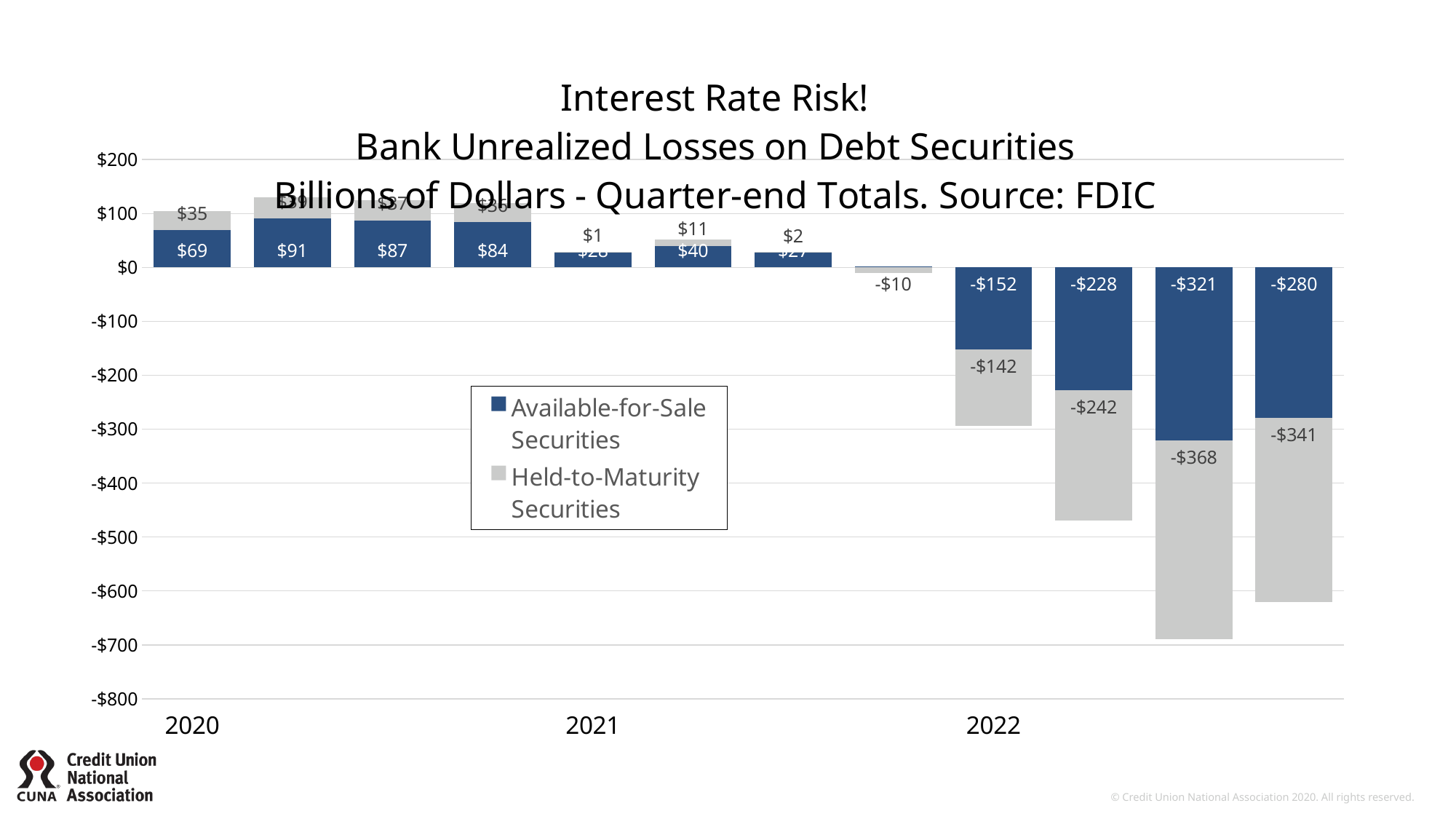
In the last bar (fourth quarter of 2022), what is the difference between the Held-to-Maturity value (-$341) and the Available-for-Sale value (-$280)? $61 Do the Available-for-Sale Securities values generally rise or fall from 2020 to 2022? Fall How many series does the legend list? 2 What is the lowest Held-to-Maturity Securities value shown? -$368 What is the Held-to-Maturity Securities value for the second bar of 2021? $11 What is the combined total of the two series in the third bar of 2022? -$689 How many bars (quarters) are plotted in the chart? 12 Which bar has the highest Available-for-Sale Securities value, and what is it? Second bar of 2020, $91 What is the Held-to-Maturity Securities value for the first bar of 2020? $35 What is the Held-to-Maturity Securities value for the third bar of 2022? -$368 What kind of chart is shown on the slide? Stacked bar chart What is the Available-for-Sale Securities value for the last bar (fourth quarter of 2022)? -$280